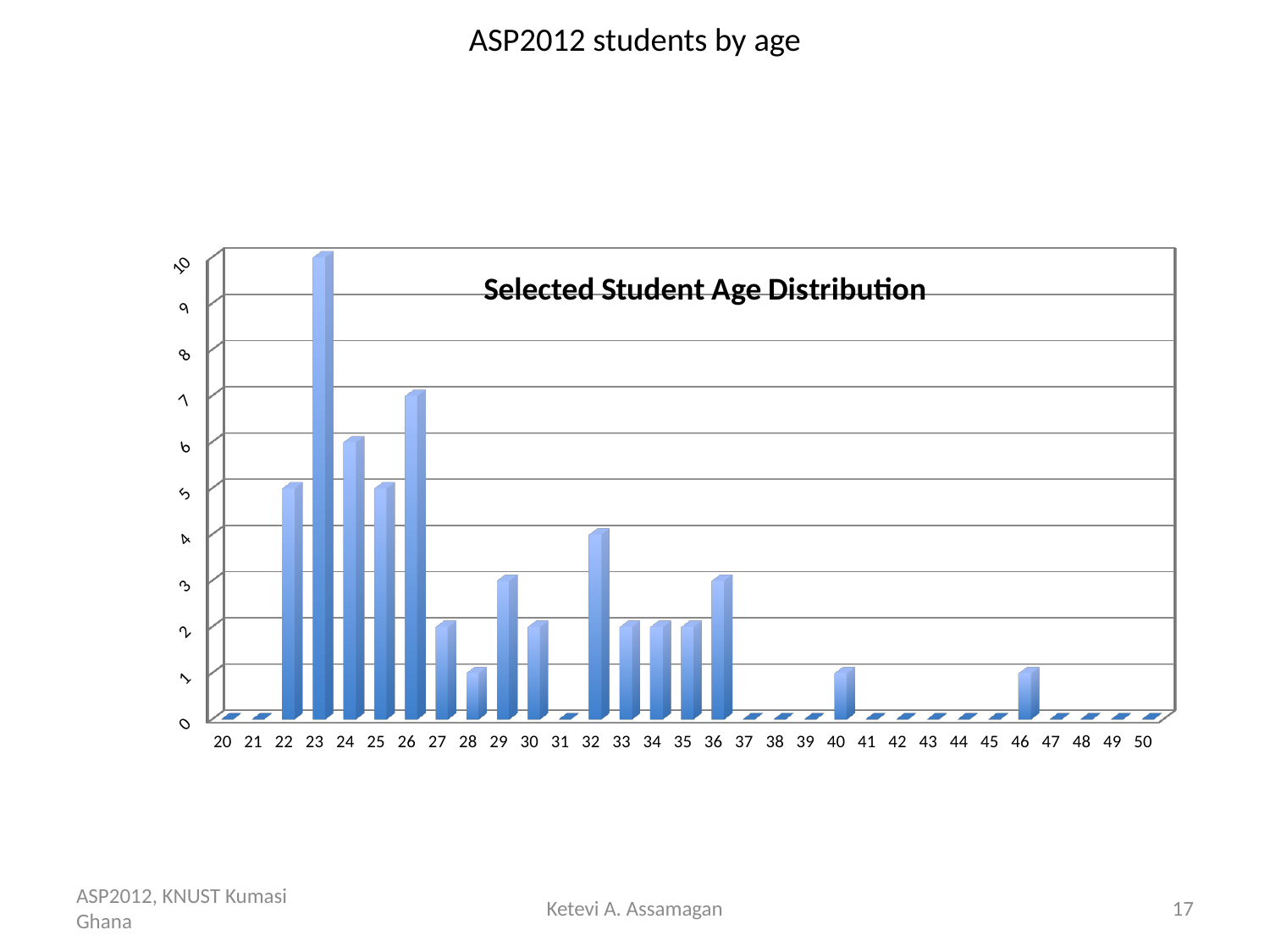
How many students are aged 32? 4 What is the highest value shown on the vertical axis? 10 How many students are aged 24? 6 Which age has the highest number of students? 23 What is the title shown inside the chart? Selected Student Age Distribution How many age categories are shown on the x axis? 31 Which has more students, age 24 or age 25? 24 What kind of chart is shown on the slide? bar chart What is the difference between the number of students aged 23 and the number aged 26? 3 How many students are aged 26? 7 How many students are aged 23? 10 Is the value for age 22 greater or less than 4? greater